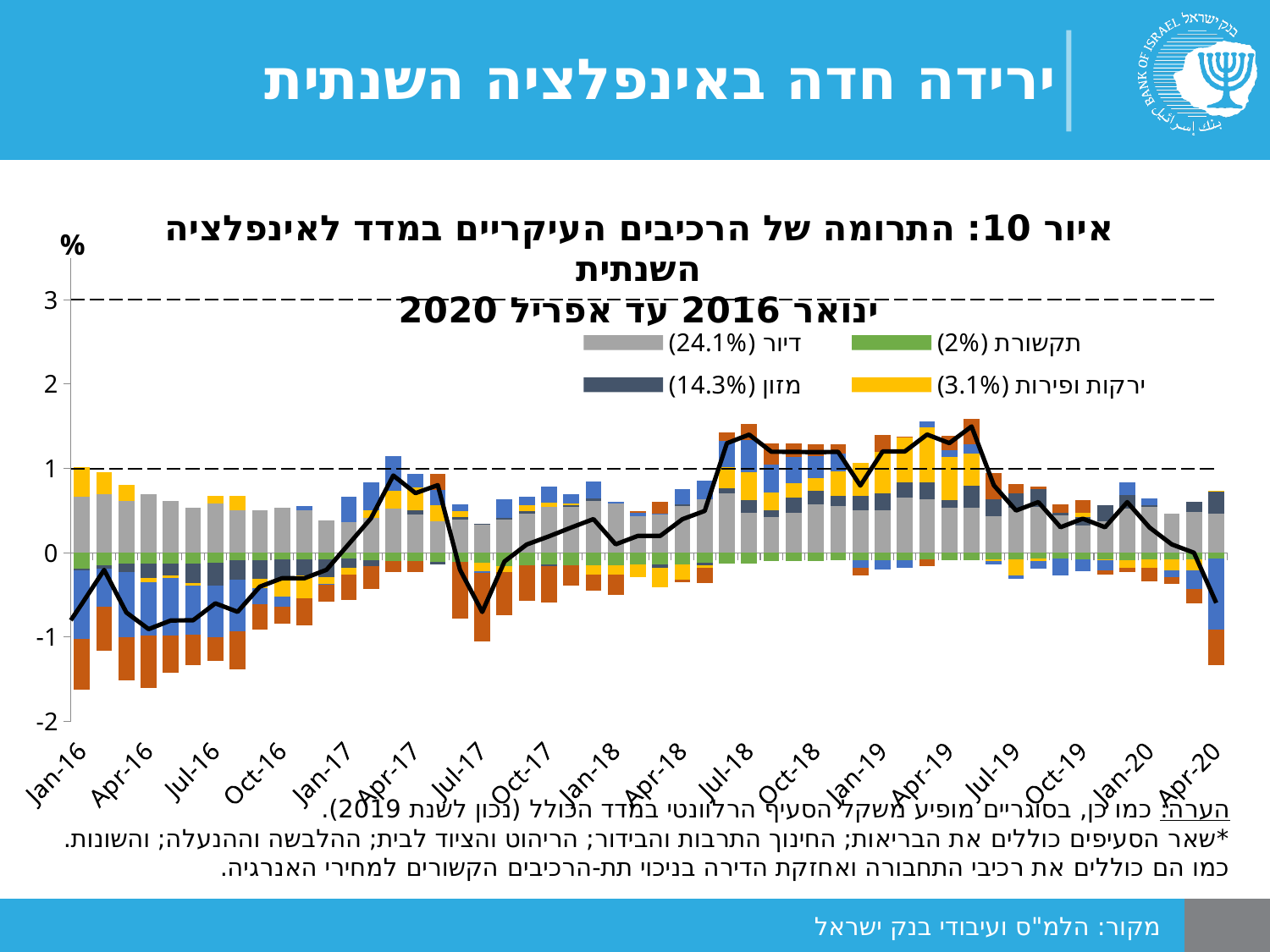
Is the value of the black line at Jul-18 greater or less than 1? greater Is the value of the black line at Jan-18 greater or less than 1? less Does the black line rise or fall between Jan-20 and Apr-20? fall What kind of chart is shown on the slide? Stacked bar chart with a line Is the value of the black line at Apr-20 greater or less than 0? less What weight is shown in the legend next to דיור? 24.1% Is the black line value at Jul-18 larger or smaller than at Jan-16? larger Does the black line rise or fall between Oct-16 and Apr-17? rise What is the highest value shown on the vertical axis? 3 What is the title of the chart? איור 10: התרומה של הרכיבים העיקריים במדד לאינפלציה השנתית ינואר 2016 עד אפריל 2020